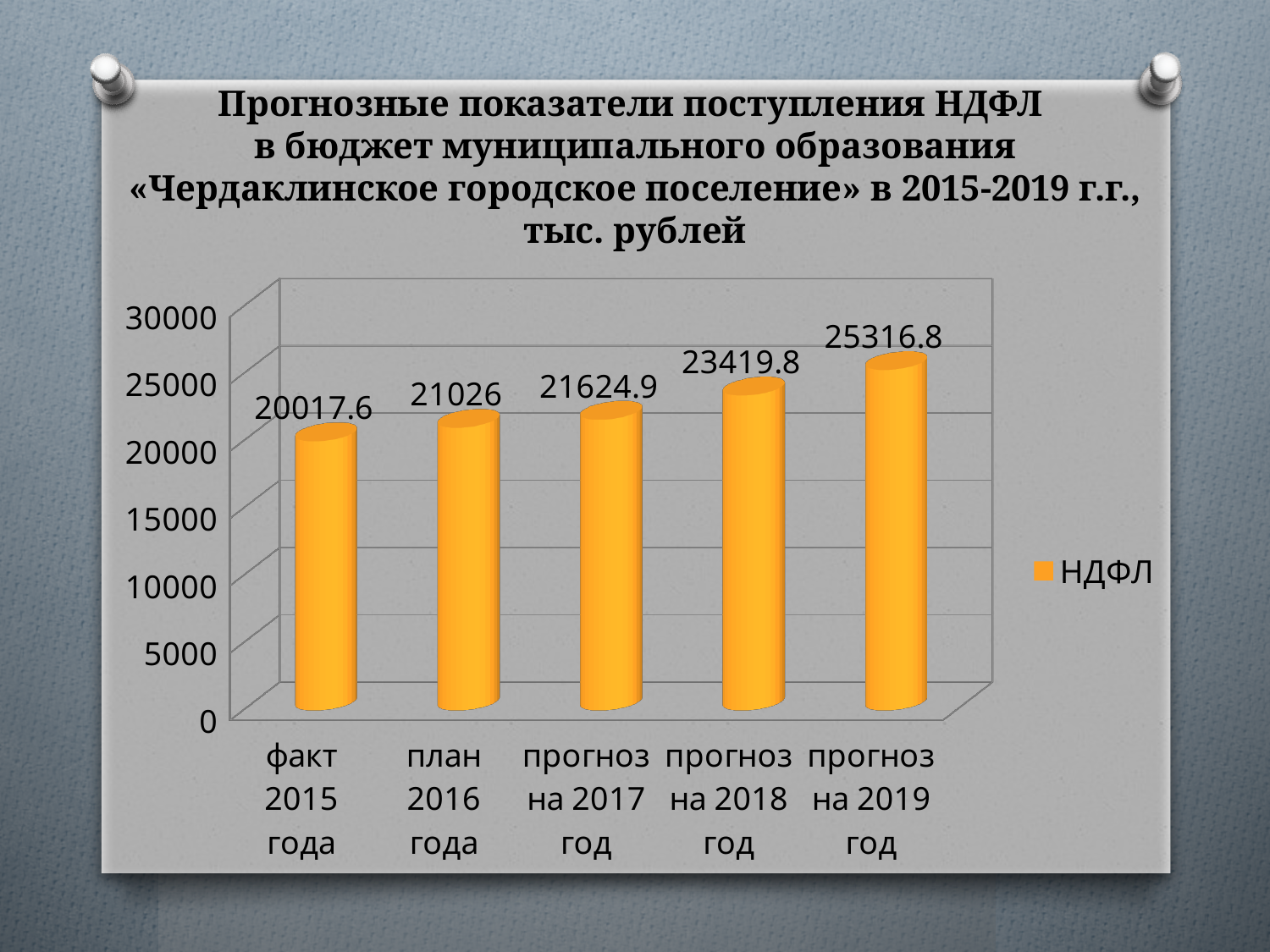
Which is larger, the value for план 2016 года or the value for прогноз на 2018 год? прогноз на 2018 год What is the difference between the values for прогноз на 2018 год and прогноз на 2017 год? 1794.9 What is the value for факт 2015 года? 20017.6 Which category has the highest value? прогноз на 2019 год What is the value for план 2016 года? 21026 Is the value for прогноз на 2017 год greater or less than 20000? greater What is the difference between the values for прогноз на 2019 год and факт 2015 года? 5299.2 What is the value for прогноз на 2019 год? 25316.8 What kind of chart is shown on the slide? bar chart How many categories are shown on the x axis? 5 Which category has the lowest value? факт 2015 года Do the values rise or fall from факт 2015 года to прогноз на 2019 год? rise